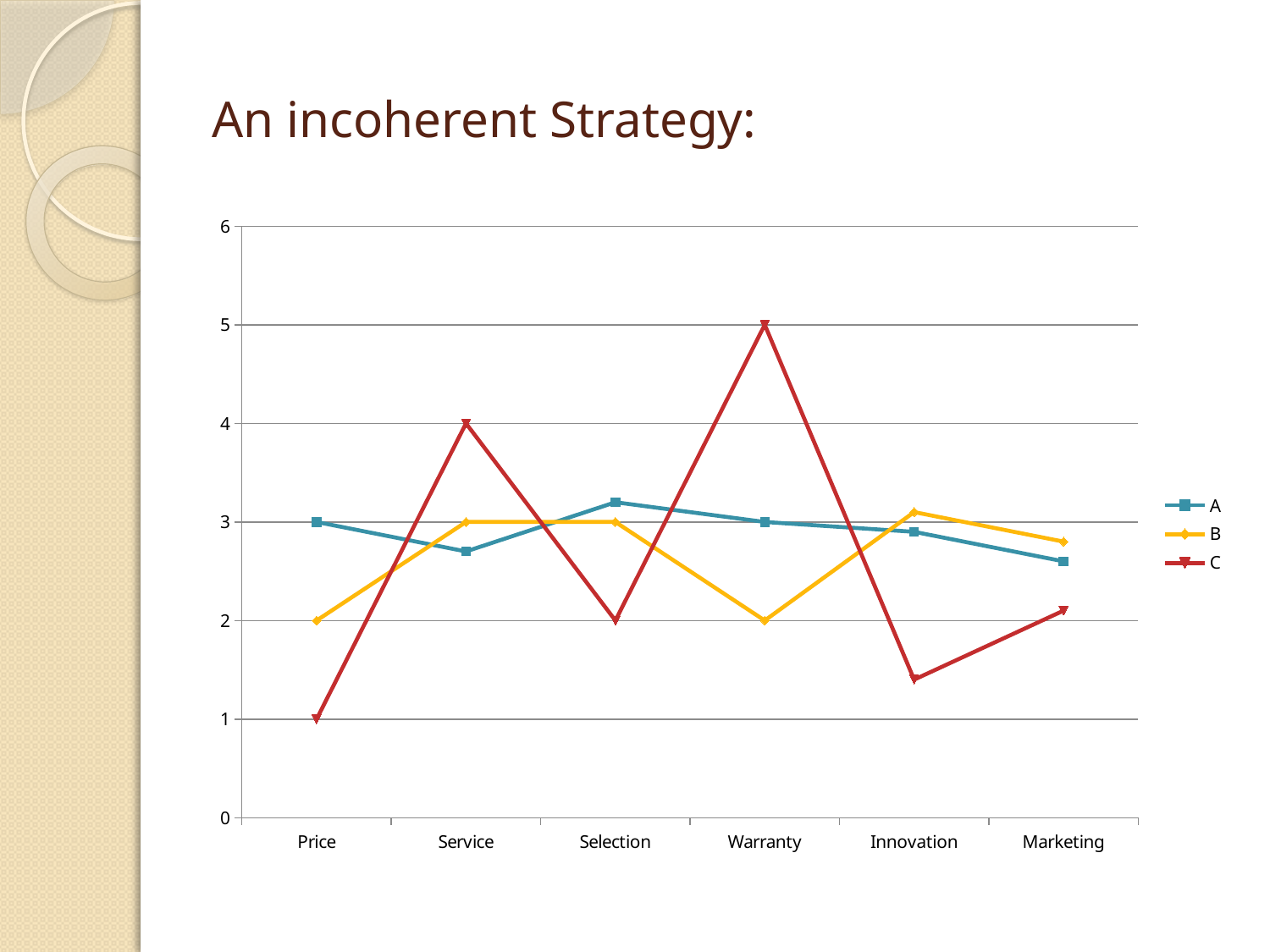
What is the value of series C for Price? 1 What kind of chart is shown on the slide? line chart What is the value of series C for Service? 4 Which series has the larger value for Warranty, A or C? C What is the difference between series C's value for Warranty and its value for Price? 4 For which category does series C reach its highest value? Warranty For which category does series C have its lowest value? Price How many series does the legend list? 3 What is the value of series B for Warranty? 2 What is the value of series C for Warranty? 5 Is the value of series C for Innovation greater or less than 2? less How many categories are shown on the x axis? 6